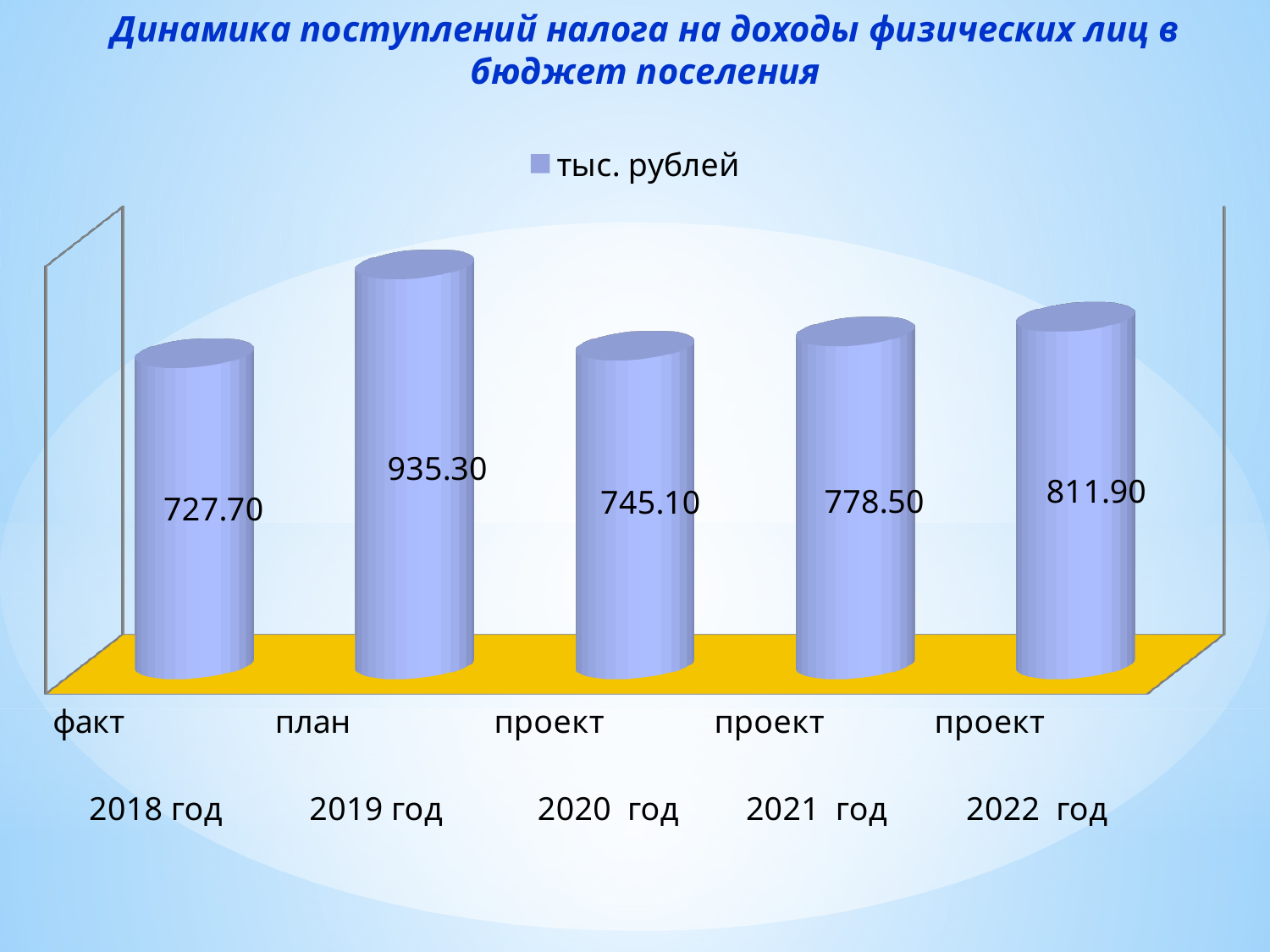
Which year has the highest value? 2019 год What is the difference between the values for 2022 год and 2021 год? 33.40 What is the value for 2022 год (проект)? 811.90 What is the value for 2020 год (проект)? 745.10 What is the value for 2018 год (факт)? 727.70 What is the value for 2019 год (план)? 935.30 What series name does the legend show? тыс. рублей Which year has the lowest value? 2018 год What kind of chart is shown on the slide? bar chart Which is larger, the value for 2021 год or the value for 2020 год? 2021 год What is the difference between the values for 2019 год and 2018 год? 207.60 How many categories are shown in the chart? 5